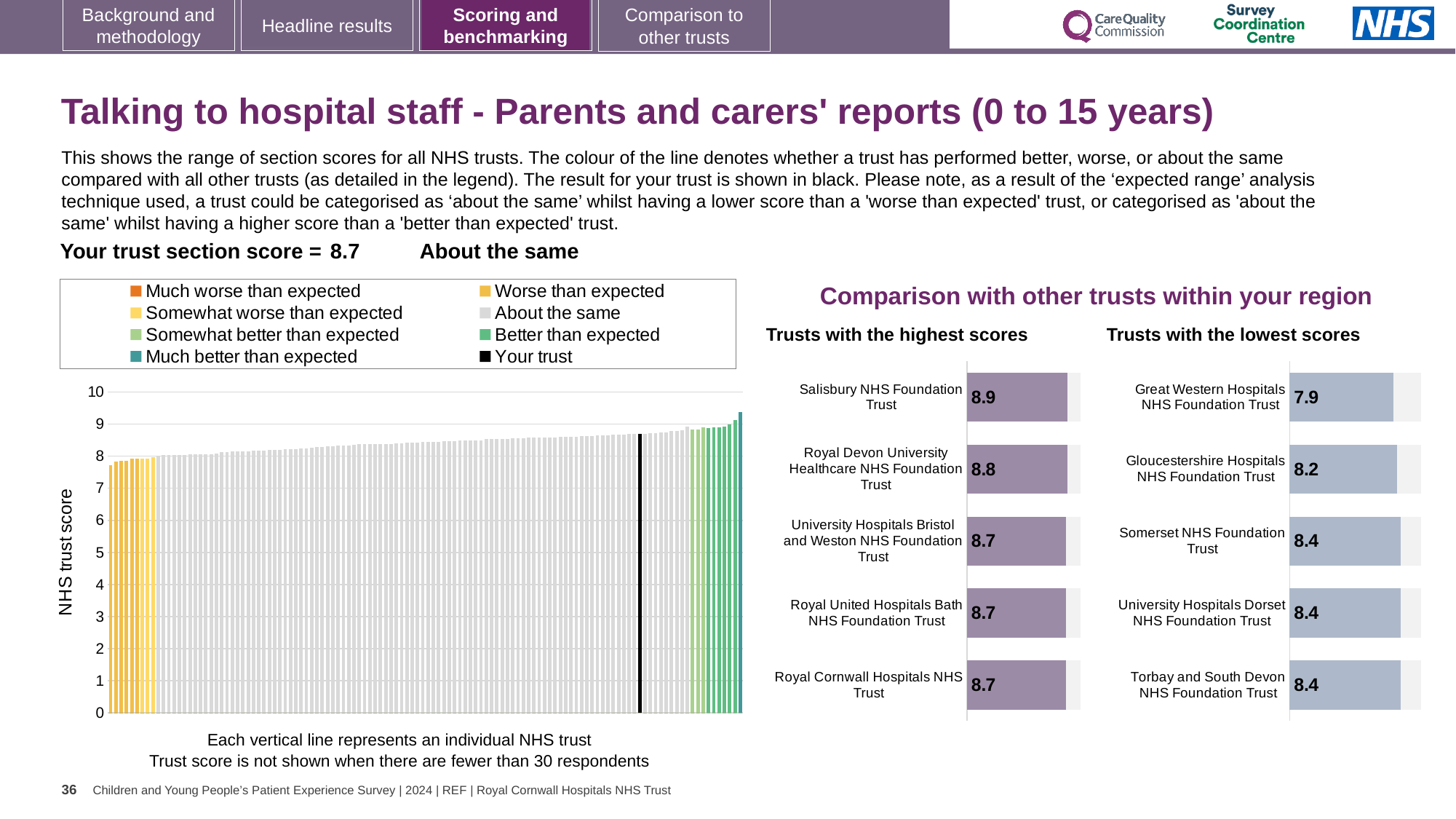
In the 'Trusts with the lowest scores' chart, what is the difference between the scores of Gloucestershire Hospitals NHS Foundation Trust and Great Western Hospitals NHS Foundation Trust? 0.3 In the 'Trusts with the lowest scores' chart, which trust has the lowest score? Great Western Hospitals NHS Foundation Trust How many entries does the legend of the NHS trust score chart list? 8 In the 'Trusts with the highest scores' chart, what is the score for Salisbury NHS Foundation Trust? 8.9 In the 'Trusts with the lowest scores' chart, what is the score for Great Western Hospitals NHS Foundation Trust? 7.9 In the 'Trusts with the highest scores' chart, what is the score for Royal Devon University Healthcare NHS Foundation Trust? 8.8 What is the difference between Salisbury NHS Foundation Trust's score in the 'Trusts with the highest scores' chart and Great Western Hospitals NHS Foundation Trust's score in the 'Trusts with the lowest scores' chart? 1.0 In the 'Trusts with the highest scores' chart, which trust has the highest score? Salisbury NHS Foundation Trust In the NHS trust score chart on the left, do the bar values rise or fall from left to right? Rise How many trusts are listed in the 'Trusts with the highest scores' chart? 5 What kind of chart is the NHS trust score chart on the left of the slide? Bar chart In the 'Trusts with the lowest scores' chart, which has the larger score: Gloucestershire Hospitals NHS Foundation Trust or Somerset NHS Foundation Trust? Somerset NHS Foundation Trust